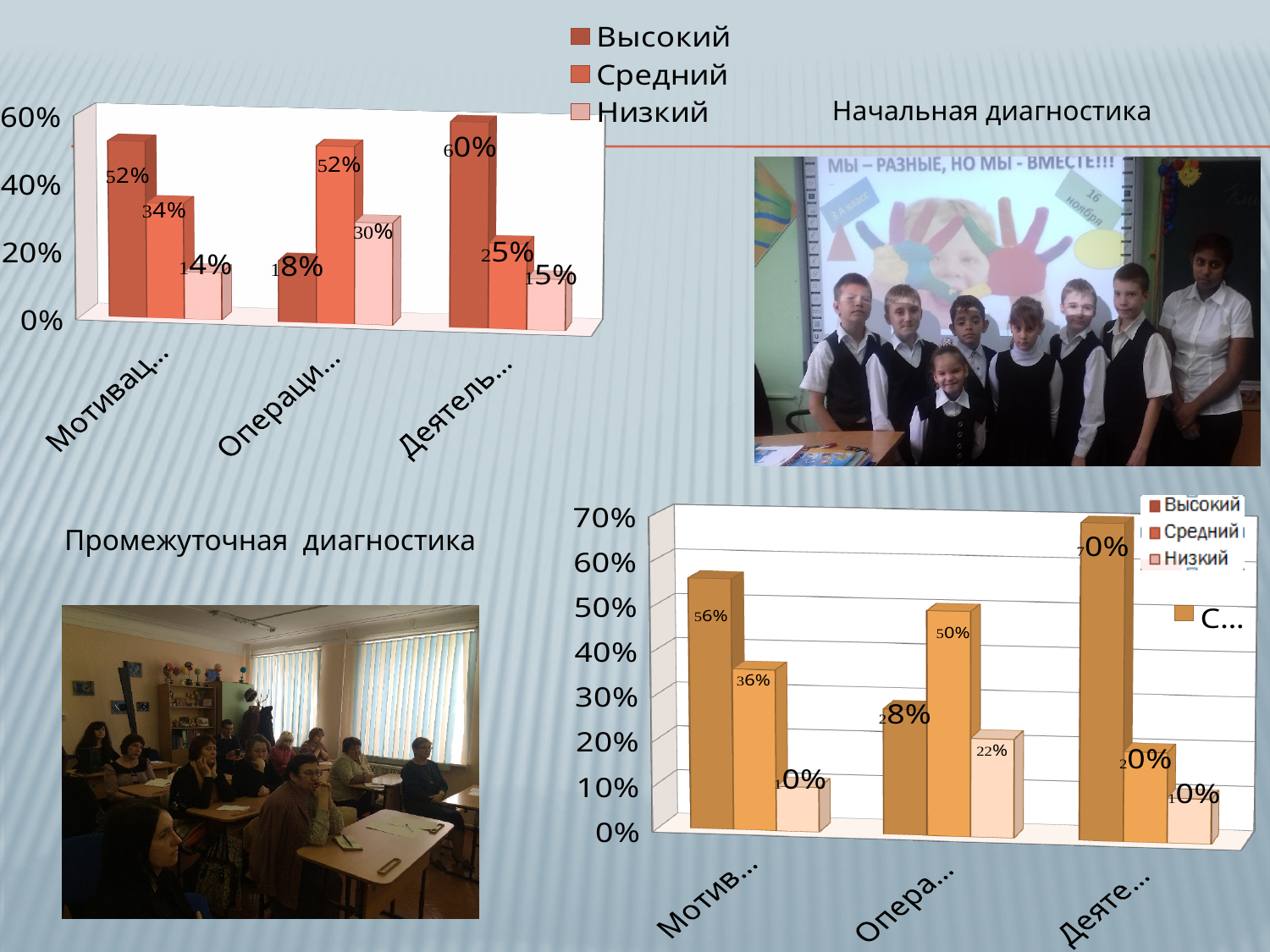
In the bottom-right chart, is the Высокий value for the second category (Опера...) larger or smaller than the Средний value for that category? Smaller In the bottom-right chart, what is the value of the Средний series for the second category (Опера...)? 50% In the bottom-right chart, what is the value of the Высокий series for the third category (Деяте...)? 70% How many series does the legend of the top-left chart list? 3 In the top-left chart, what is the difference between the Высокий and Средний values for the first category (Мотивац...)? 18% In the bottom-right chart, which series has the lowest value for the first category (Мотив...)? Низкий In the top-left chart, what is the value of the Высокий series for the first category (Мотивац...)? 52% How many categories are shown on the x axis of the bottom-right chart? 3 In the top-left chart, what is the value of the Низкий series for the third category (Деятель...)? 15% In the top-left chart, what is the value of the Средний series for the second category (Операци...)? 52% What kind of chart is the top-left chart? Bar chart In the top-left chart, which series has the highest value for the third category (Деятель...)? Высокий